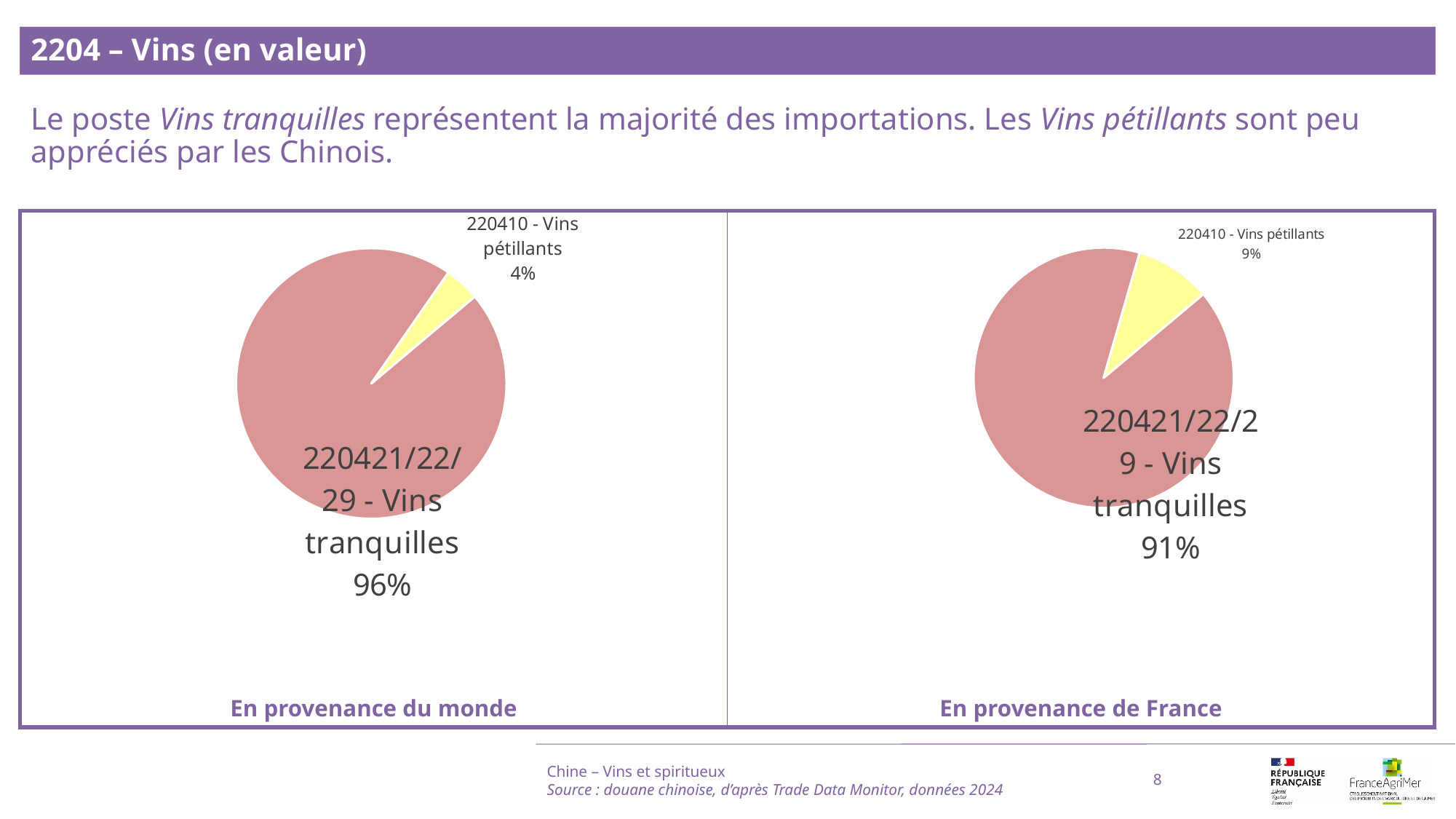
How many categories are shown in the 'En provenance de France' chart? 2 In the 'En provenance du monde' chart, which category has the largest slice? 220421/22/29 - Vins tranquilles In the 'En provenance de France' chart, what is the difference in percentage points between Vins tranquilles and Vins pétillants? 82 percentage points In the 'En provenance du monde' chart, what share do Vins tranquilles (220421/22/29) represent? 96% In the 'En provenance de France' chart, what share do Vins pétillants (220410) represent? 9% In the 'En provenance du monde' chart, what colour is the Vins pétillants slice? Yellow What type of chart is used in the 'En provenance du monde' panel? Pie chart In the 'En provenance de France' chart, which category has the smallest slice? 220410 - Vins pétillants In the 'En provenance du monde' chart, what share do Vins pétillants (220410) represent? 4% In the 'En provenance du monde' chart, what is the difference in percentage points between Vins tranquilles and Vins pétillants? 92 percentage points Is the share of Vins pétillants larger in the 'En provenance du monde' chart or in the 'En provenance de France' chart? En provenance de France In the 'En provenance de France' chart, what share do Vins tranquilles (220421/22/29) represent? 91%